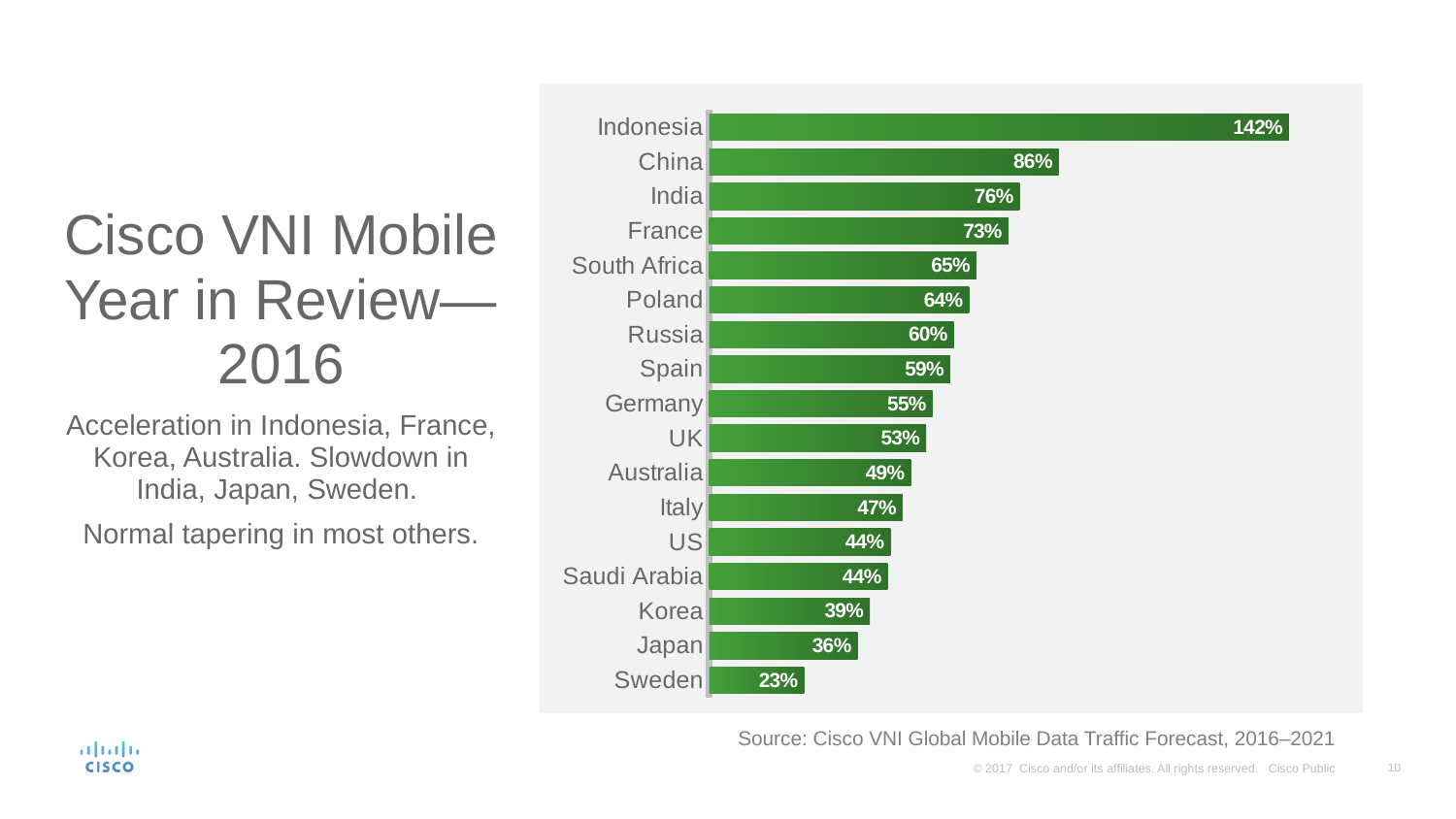
Which country has the lowest value in the chart? Sweden What is the value shown for Indonesia? 142% What kind of chart is shown on the slide? Bar chart Which has a larger value, Germany or Australia? Germany How many countries are shown in the chart? 17 What is the value shown for France? 73% Which country has the highest value in the chart? Indonesia Which has a larger value, Korea or Russia? Russia What is the value shown for Saudi Arabia? 44% What is the difference between the values for Indonesia and Sweden? 119% What is the difference between the values for China and India? 10% What is the value shown for Japan? 36%